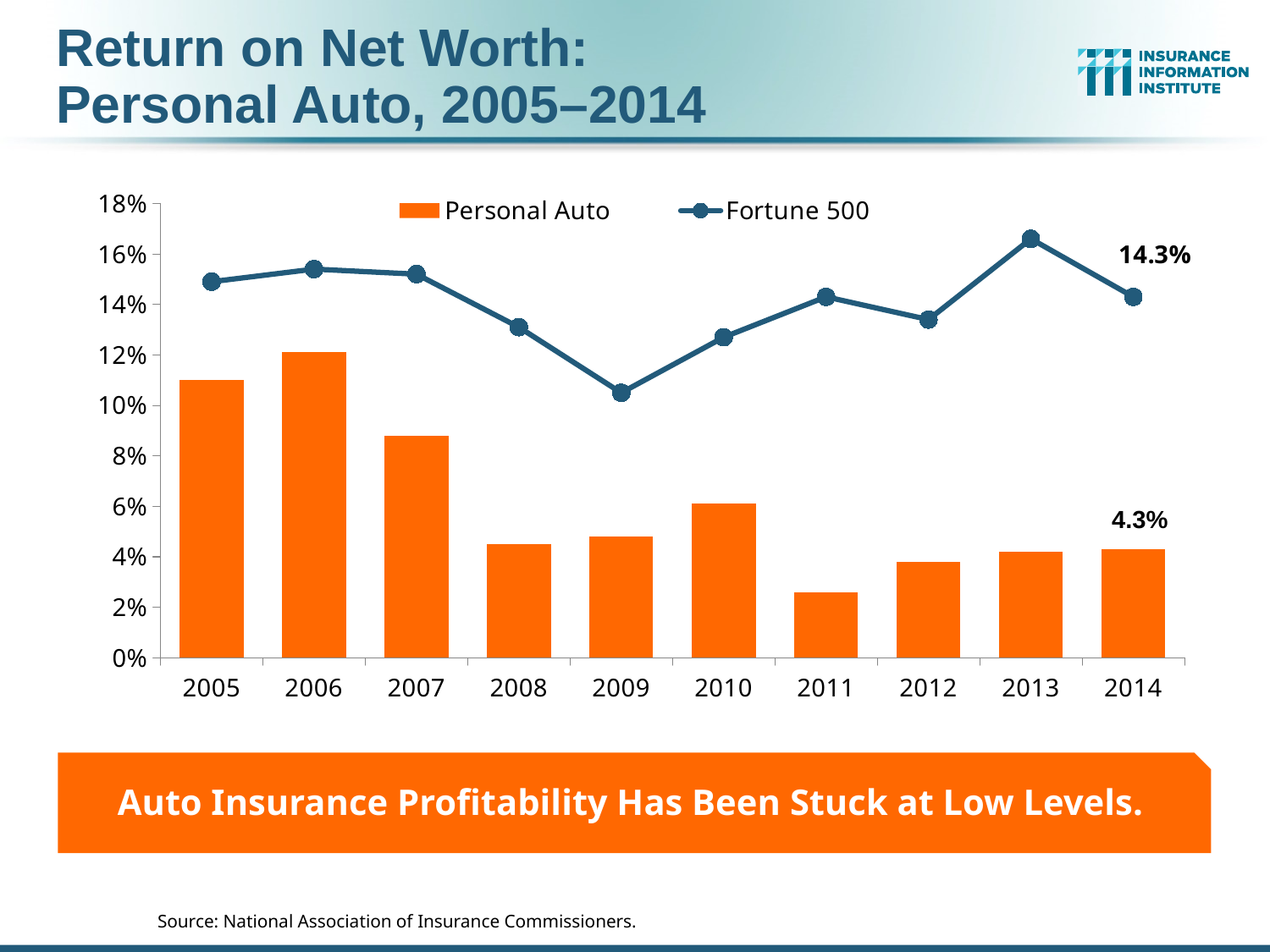
In which year is the Fortune 500 return on net worth highest? 2013 In 2014, how much higher is the Fortune 500 value than the Personal Auto value? 10 percentage points In which year is the Fortune 500 return on net worth lowest? 2009 In 2014, which is larger: the Fortune 500 value or the Personal Auto value? Fortune 500 Is the Personal Auto value for 2005 greater or less than 10%? greater What is the Fortune 500 return on net worth for 2014? 14.3% In which year is the Personal Auto return on net worth highest? 2006 In which year is the Personal Auto return on net worth lowest? 2011 What is the Personal Auto return on net worth for 2014? 4.3% How many series does the chart's legend list? 2 Is the Fortune 500 value for 2009 greater or less than 12%? less How many years are shown on the x axis of the chart? 10